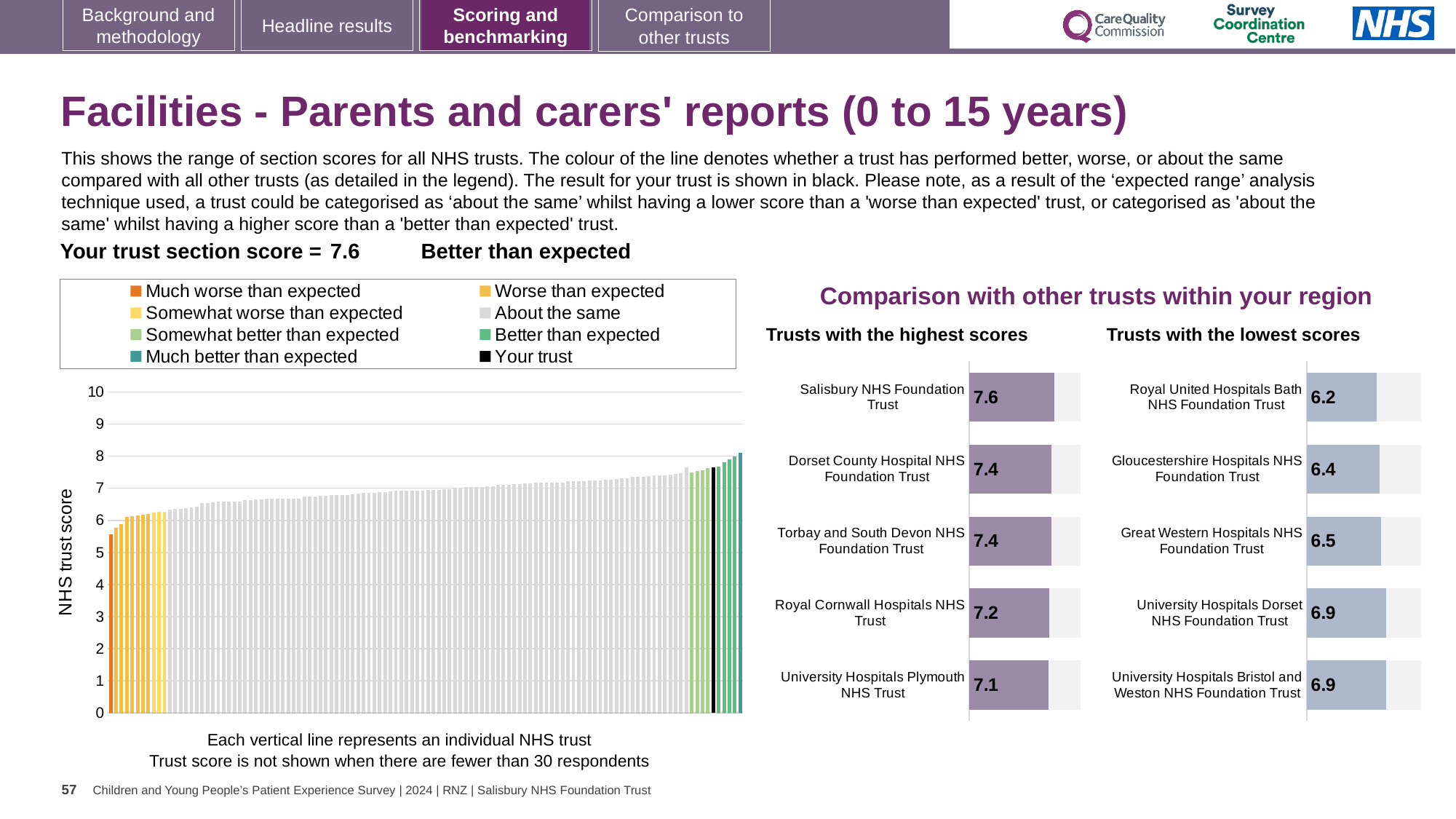
What kind of chart is the 'Trusts with the lowest scores' chart? Bar chart In the 'Trusts with the lowest scores' chart, what is the score for Royal United Hospitals Bath NHS Foundation Trust? 6.2 How many trusts are shown in the 'Trusts with the highest scores' chart? 5 In the 'Trusts with the highest scores' chart, what is the score for Salisbury NHS Foundation Trust? 7.6 In the main chart on the left, is the value for the black 'Your trust' line greater or less than 7? greater In the 'Trusts with the lowest scores' chart, what is the difference between the scores of Gloucestershire Hospitals NHS Foundation Trust and Royal United Hospitals Bath NHS Foundation Trust? 0.2 In the 'Trusts with the lowest scores' chart, what is the score for University Hospitals Dorset NHS Foundation Trust? 6.9 In the 'Trusts with the highest scores' chart, what is the difference between the scores of Salisbury NHS Foundation Trust and University Hospitals Plymouth NHS Trust? 0.5 In the 'Trusts with the lowest scores' chart, which trust has the lowest score? Royal United Hospitals Bath NHS Foundation Trust In the 'Trusts with the lowest scores' chart, which has the higher score: Gloucestershire Hospitals NHS Foundation Trust or Great Western Hospitals NHS Foundation Trust? Great Western Hospitals NHS Foundation Trust In the main chart on the left, do the trust scores rise or fall from left to right? Rise In the 'Trusts with the highest scores' chart, which trust has the highest score? Salisbury NHS Foundation Trust